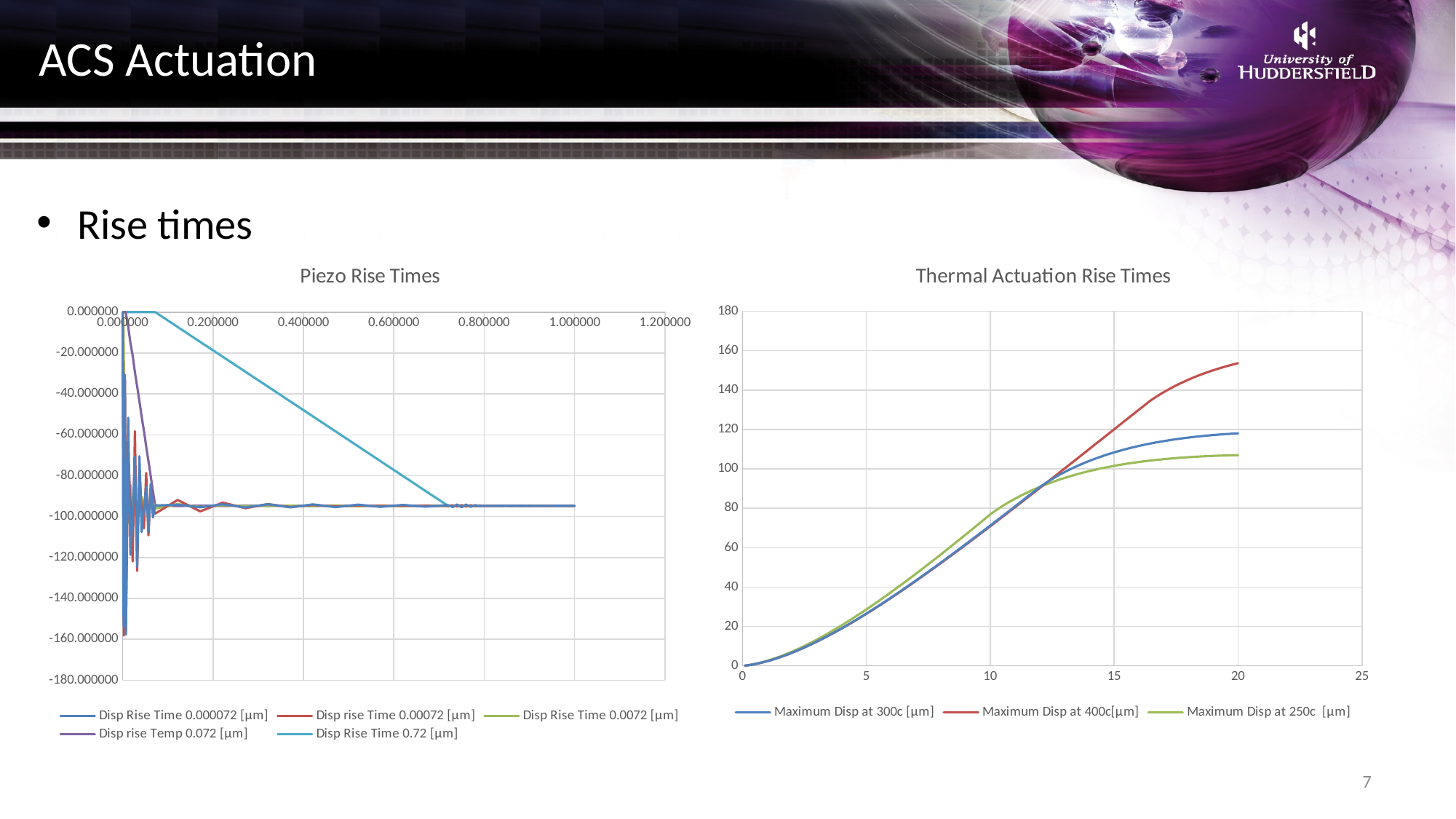
In the Thermal Actuation Rise Times chart, which series has the lowest value at x = 20? Maximum Disp at 250c [μm] In the Thermal Actuation Rise Times chart, at x = 20, is the value for Maximum Disp at 250c [μm] greater or less than 120? less How many series does the legend of the Thermal Actuation Rise Times chart list? 3 In the Thermal Actuation Rise Times chart, which series reaches the highest value at x = 20? Maximum Disp at 400c[μm] In the Thermal Actuation Rise Times chart, at x = 20, is the value for Maximum Disp at 400c[μm] greater or less than 140? greater What kind of chart is the Piezo Rise Times chart? line chart In the Thermal Actuation Rise Times chart, at x = 20, is the value for Maximum Disp at 300c [μm] greater or less than 100? greater In the Thermal Actuation Rise Times chart, do the values rise or fall as the x axis increases? rise How many series does the legend of the Piezo Rise Times chart list? 5 In the Thermal Actuation Rise Times chart, at x = 20, which is larger: Maximum Disp at 400c[μm] or Maximum Disp at 250c [μm]? Maximum Disp at 400c[μm] What kind of chart is the Thermal Actuation Rise Times chart? line chart What is the title of the chart on the left of the slide? Piezo Rise Times